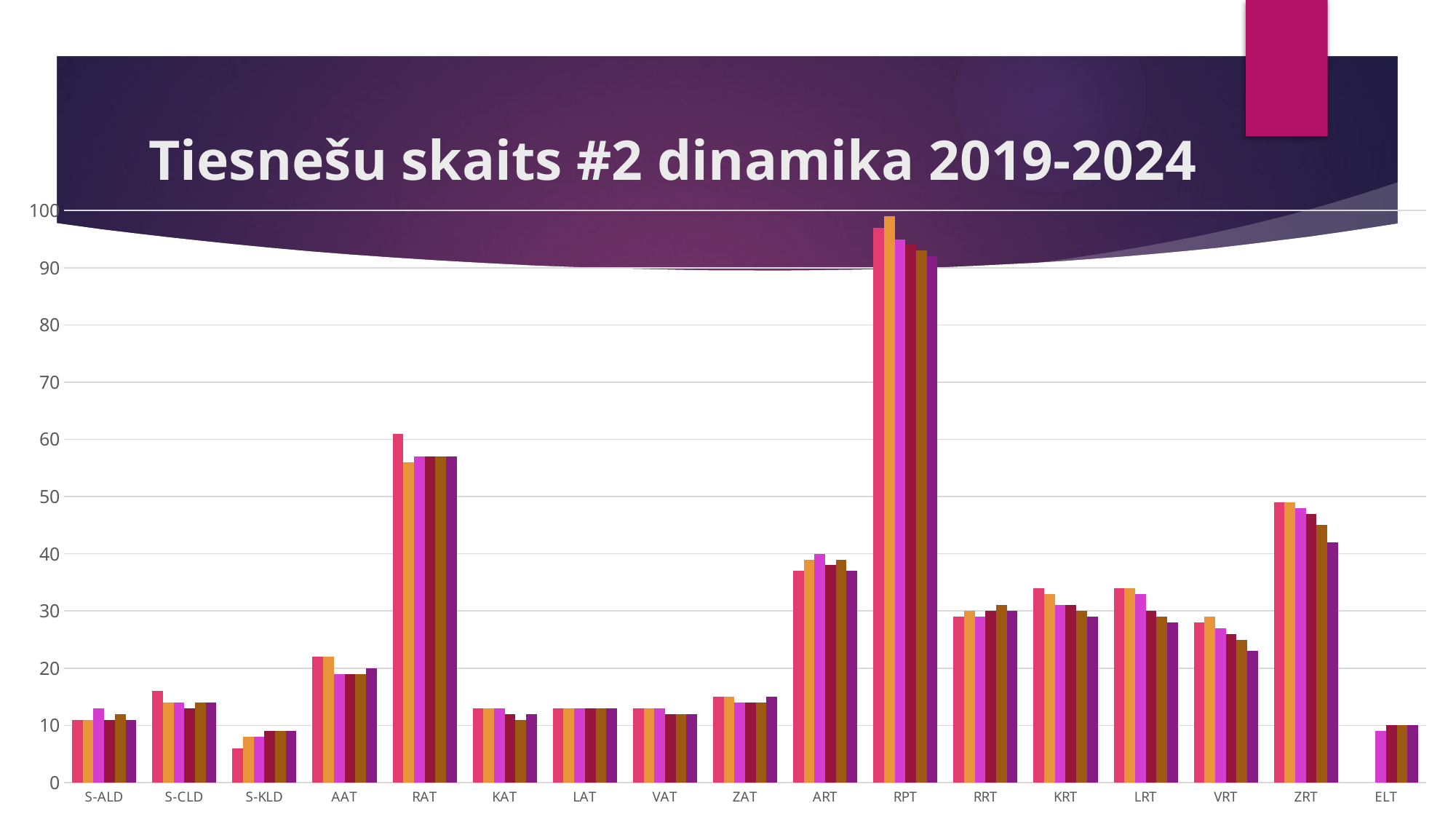
Are the values for ELT greater or less than 20? less Which category has larger values, ART or KRT? ART What is the title of the chart? Tiesnešu skaits #2 dinamika 2019-2024 What kind of chart is shown on the slide? bar chart Which category has larger values, RAT or ZRT? RAT How many categories are shown along the x axis? 17 How many bars are plotted for each category? 6 Are the values for RAT greater or less than 50? greater Which category has the tallest bars? RPT Are the values for ZRT greater or less than 40? greater Which category has the shortest bar on the chart? S-KLD